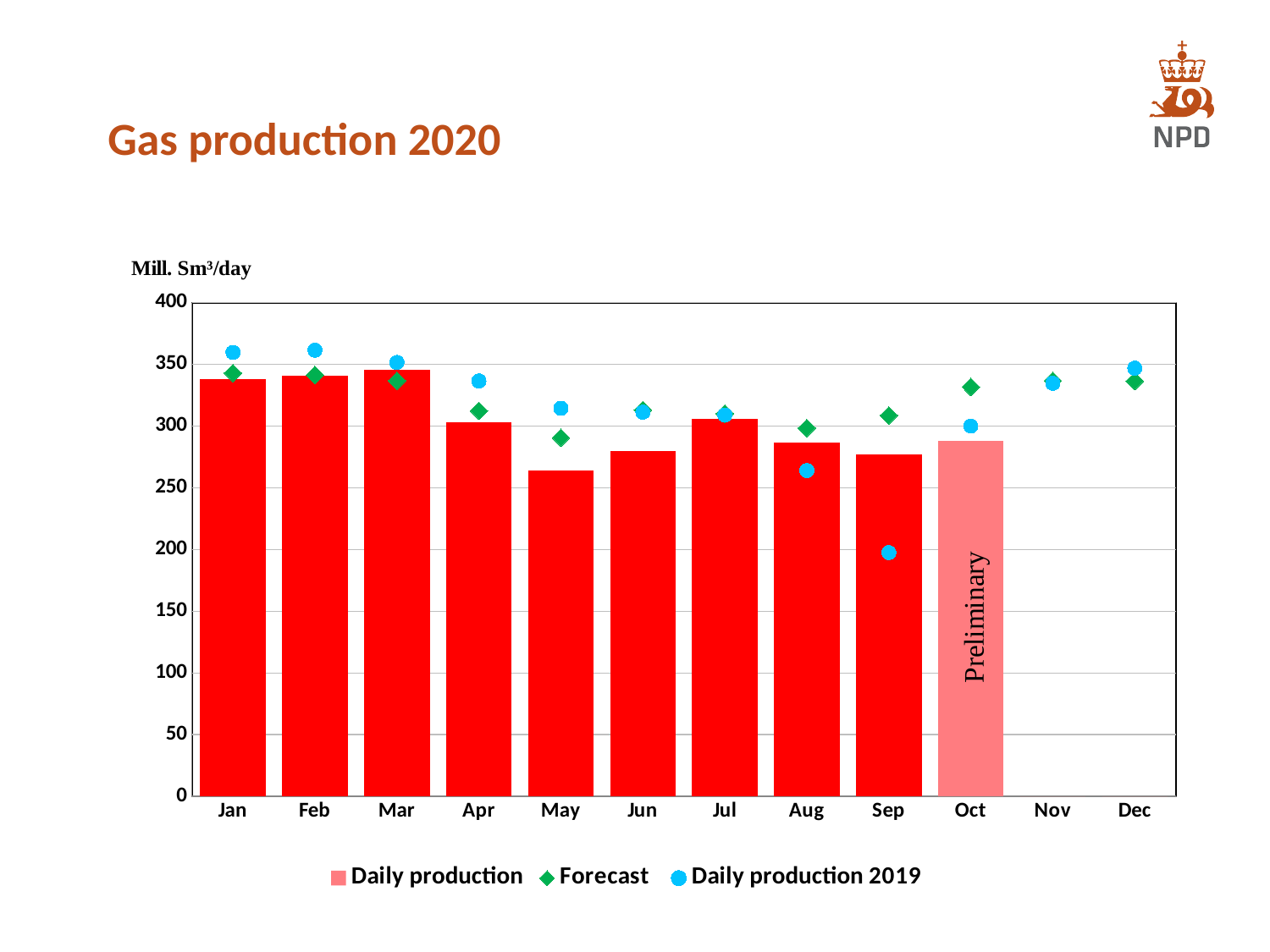
How many series does the legend list? 3 How many months are shown on the x axis? 12 Is the Daily production 2019 value for Sep greater or less than 250? less Which is larger, the Daily production bar for Jan or for May? Jan Which month has the lowest Daily production bar? May Is the Daily production value for May greater or less than 300? less Which month has the lowest Forecast value? May Do the Daily production bars rise or fall from Jan to May? fall Is the Daily production value for Jan greater or less than 300? greater What kind of chart is shown on the slide? bar chart Which month has the lowest Daily production 2019 value? Sep In Sep, which is larger, the Daily production bar or the Daily production 2019 point? Daily production